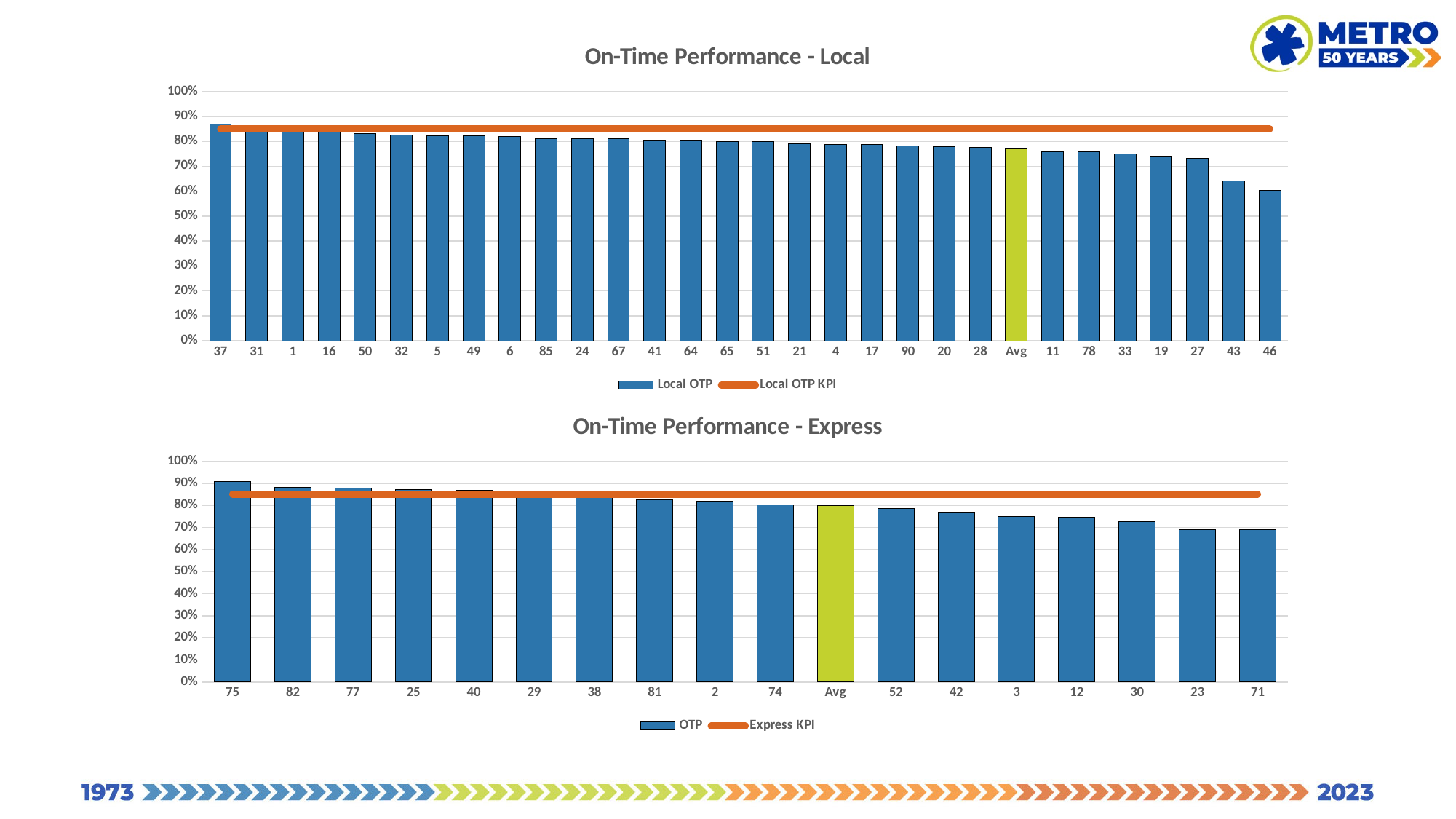
On the 'On-Time Performance - Local' chart, is the value for route 46 greater or less than 70%? less On the 'On-Time Performance - Local' chart, is the value for route 37 greater or less than 80%? greater On the 'On-Time Performance - Express' chart, how many series does the legend list? 2 On the 'On-Time Performance - Local' chart, which route has the lowest on-time performance? 46 On the 'On-Time Performance - Express' chart, is the value for route 3 greater or less than 80%? less On the 'On-Time Performance - Express' chart, which is larger, the value for route 75 or the value for route 23? 75 On the 'On-Time Performance - Express' chart, which route has the highest on-time performance? 75 On the 'On-Time Performance - Local' chart, do the bar values rise or fall from left to right along the x axis? Fall On the 'On-Time Performance - Local' chart, which route has the highest on-time performance? 37 On the 'On-Time Performance - Express' chart, how many categories are shown on the x axis? 18 What kind of chart is the 'On-Time Performance - Local' chart? Combination bar and line chart On the 'On-Time Performance - Local' chart, how many categories are shown on the x axis? 30